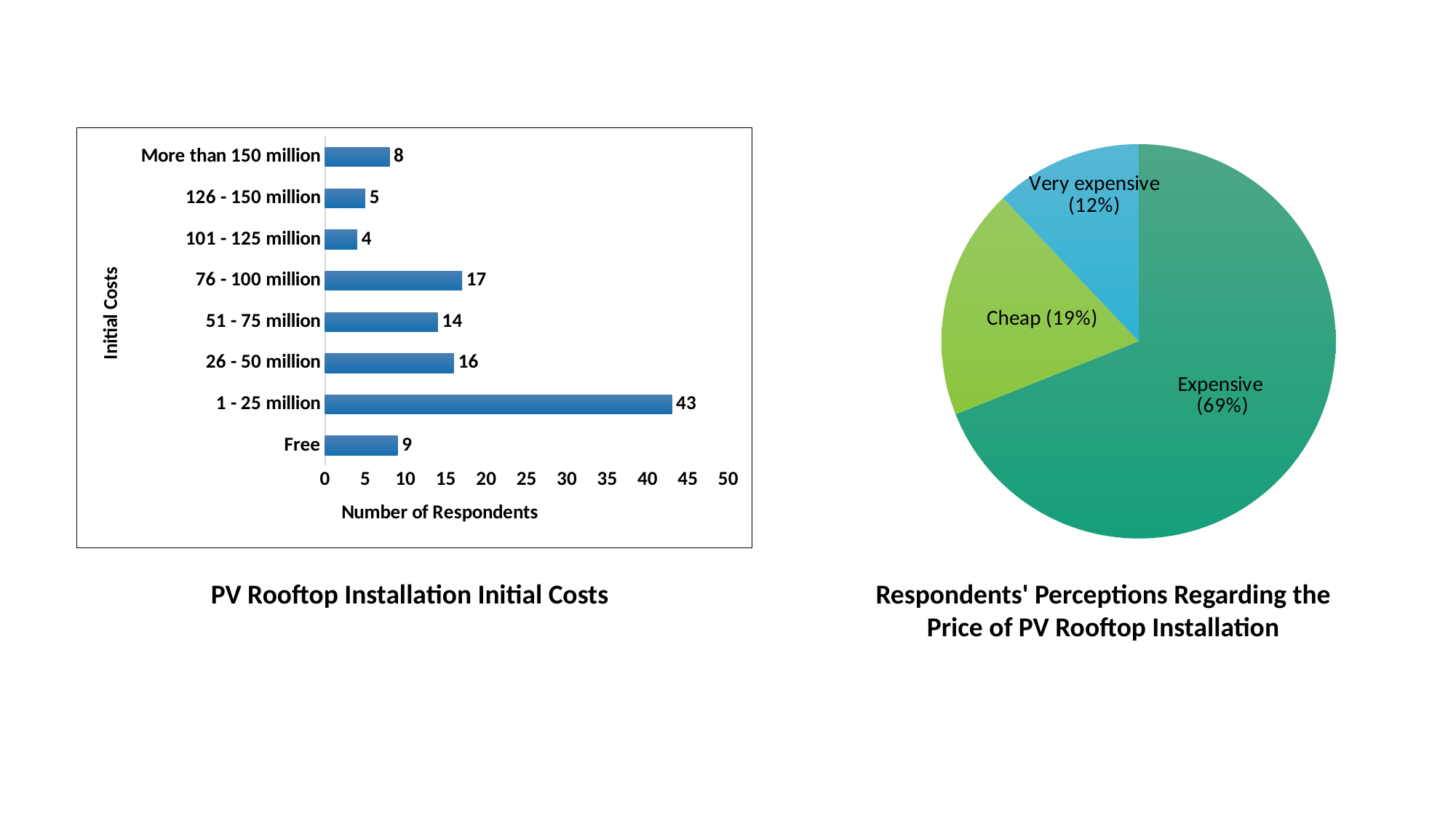
What type of chart is 'Respondents' Perceptions Regarding the Price of PV Rooftop Installation'? Pie chart In the 'PV Rooftop Installation Initial Costs' chart, which initial cost category has the highest number of respondents? 1 - 25 million In the 'Respondents' Perceptions Regarding the Price of PV Rooftop Installation' chart, what share of respondents perceive the price as Cheap? 19% In the 'PV Rooftop Installation Initial Costs' chart, which initial cost category has the lowest number of respondents? 101 - 125 million In the 'PV Rooftop Installation Initial Costs' chart, how many initial cost categories are shown? 8 In the 'PV Rooftop Installation Initial Costs' chart, how many respondents reported initial costs of 1 - 25 million? 43 In the 'PV Rooftop Installation Initial Costs' chart, how many respondents reported initial costs of 76 - 100 million? 17 In the 'PV Rooftop Installation Initial Costs' chart, which has more respondents: Free or More than 150 million? Free What type of chart is 'PV Rooftop Installation Initial Costs'? Bar chart In the 'Respondents' Perceptions Regarding the Price of PV Rooftop Installation' chart, which perception has the largest share? Expensive In the 'PV Rooftop Installation Initial Costs' chart, what is the difference in respondents between the 1 - 25 million and 26 - 50 million categories? 27 In the 'PV Rooftop Installation Initial Costs' chart, what is the label of the horizontal axis? Number of Respondents